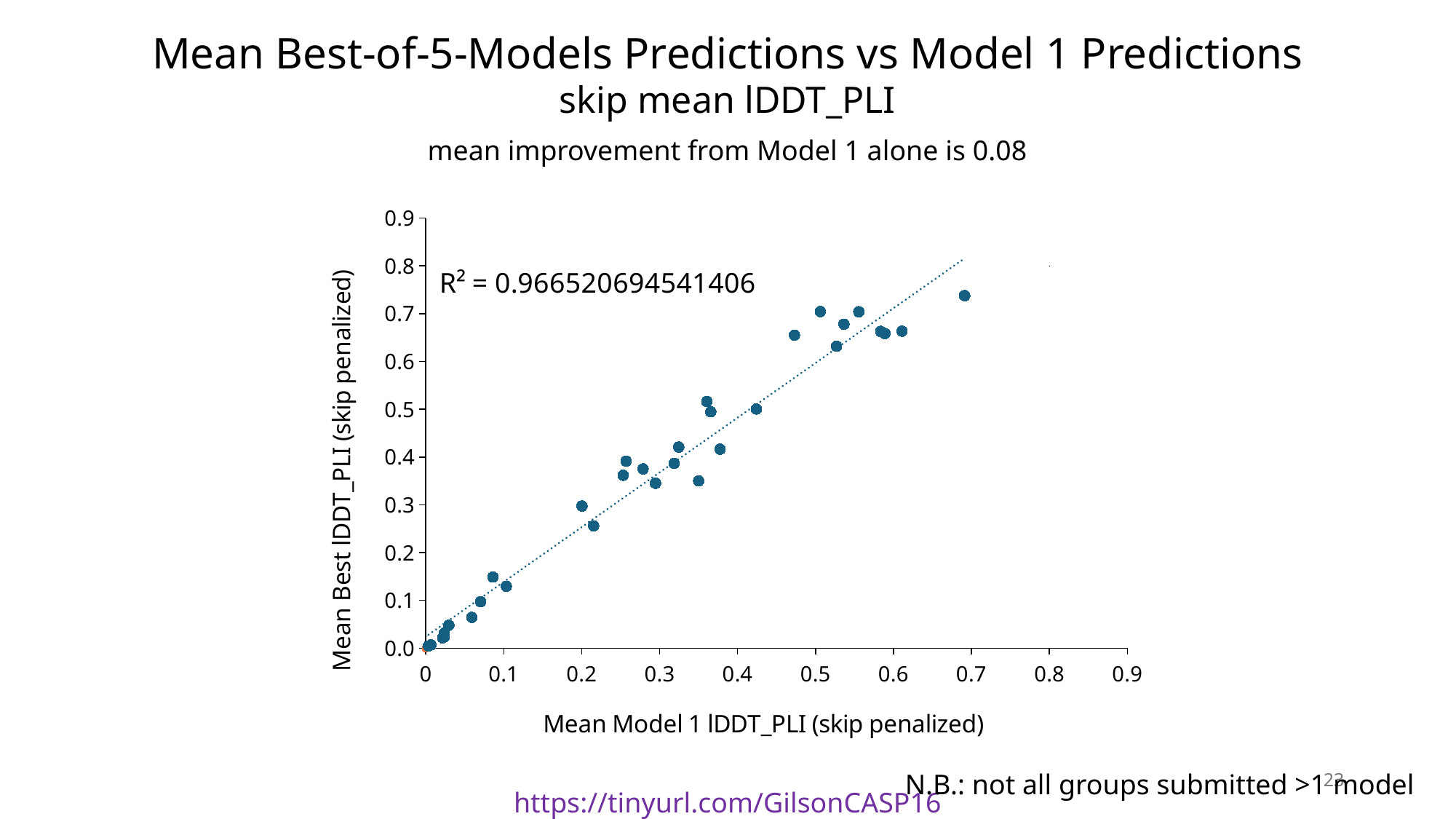
What is the title of the x axis? Mean Model 1 lDDT_PLI (skip penalized) Is the y value of the rightmost point greater or less than 0.7? greater Is the y value of the point at x ≈ 0.2 greater or less than 0.4? less What is the maximum value shown on the y axis? 0.9 Do the plotted points generally rise or fall as the x value increases? rise What kind of chart is shown on the slide? scatter plot What R² value is printed on the chart? R² = 0.966520694541406 Is the x value of the rightmost point greater or less than 0.6? greater What is the maximum value shown on the x axis? 0.9